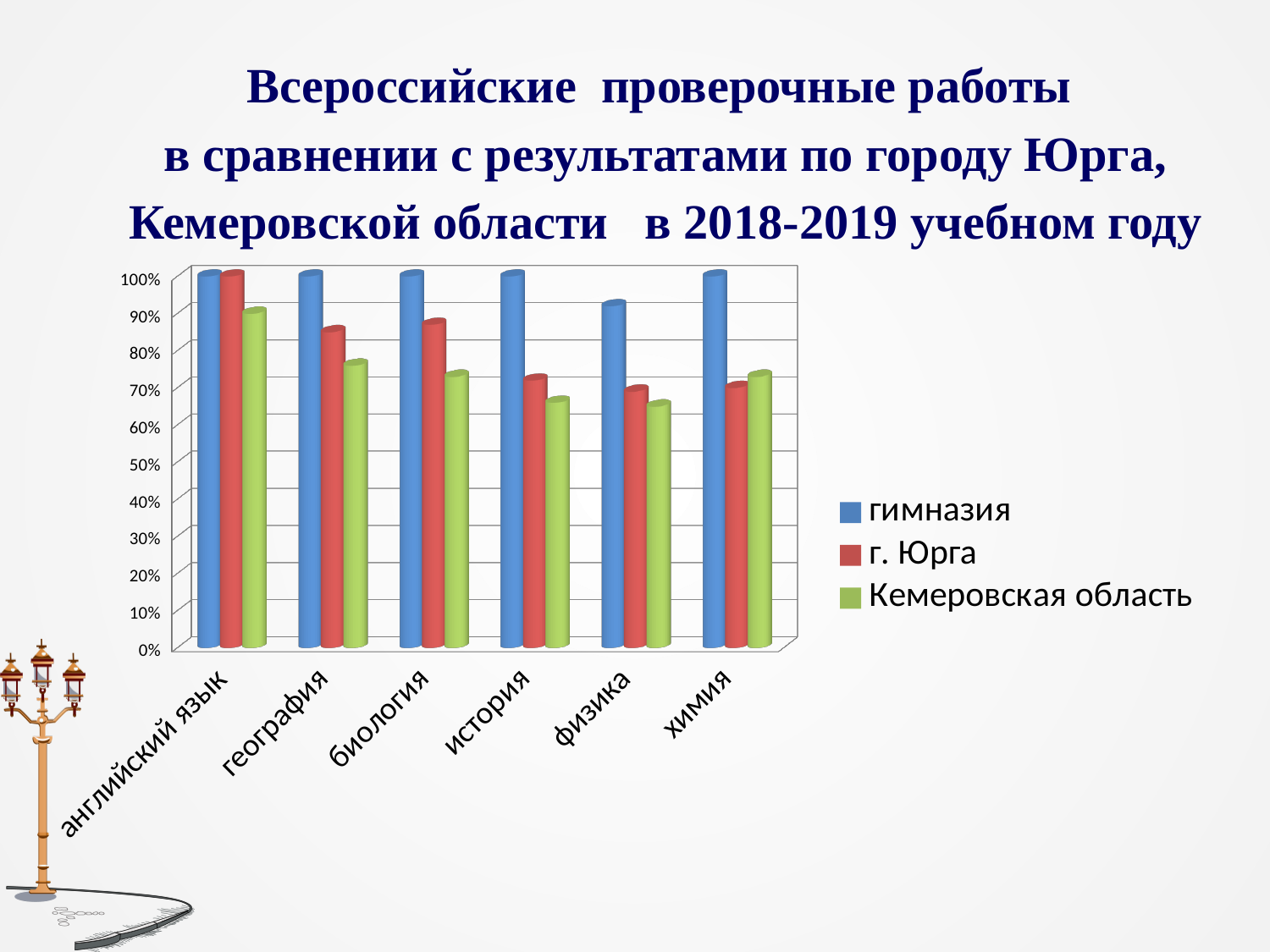
Is the value for Кемеровская область in английский язык greater or less than 80%? greater What kind of chart is shown on the slide? bar chart In география, which is larger: the value for г. Юрга or for Кемеровская область? г. Юрга Is the value for г. Юрга in биология greater or less than 80%? greater How many series does the legend list? 3 Is the value for Кемеровская область in физика greater or less than 70%? less Which colour represents г. Юрга in the legend? red In физика, which is larger: the value for гимназия or for г. Юрга? гимназия For the гимназия series, which subject has the lowest value? физика How many subject categories are shown on the x axis? 6